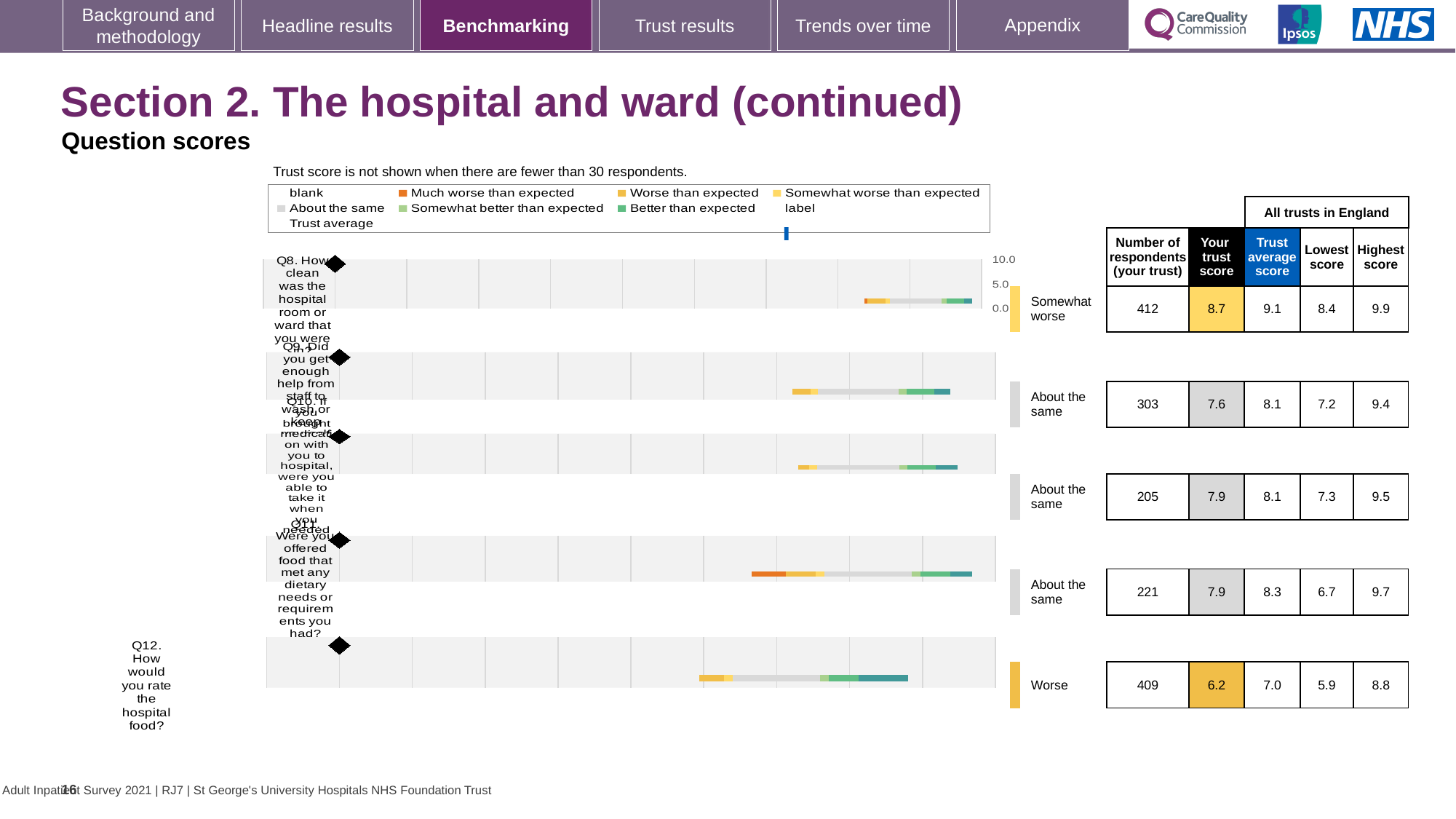
What kind of chart is used to show the question scores on this slide? bar chart How many questions (Q8 to Q12) are plotted in the chart? 5 Which legend entry is shown in dark orange? Much worse than expected What is the 'Your trust score' for Q8 (How clean was the hospital room or ward)? 8.7 What is the lowest score across all trusts in England for Q10? 7.3 What benchmark category label is given to Q12 (hospital food)? Worse For Q9, which is larger: the 'Your trust score' or the 'Trust average score'? Trust average score For Q12, what is the difference between the highest score and the lowest score across all trusts in England? 2.9 Which question has the highest 'Your trust score'? Q8 What is the 'Trust average score' for Q12 (How would you rate the hospital food)? 7.0 How many respondents from your trust answered Q11 (dietary needs)? 221 Which question has the lowest 'Your trust score'? Q12